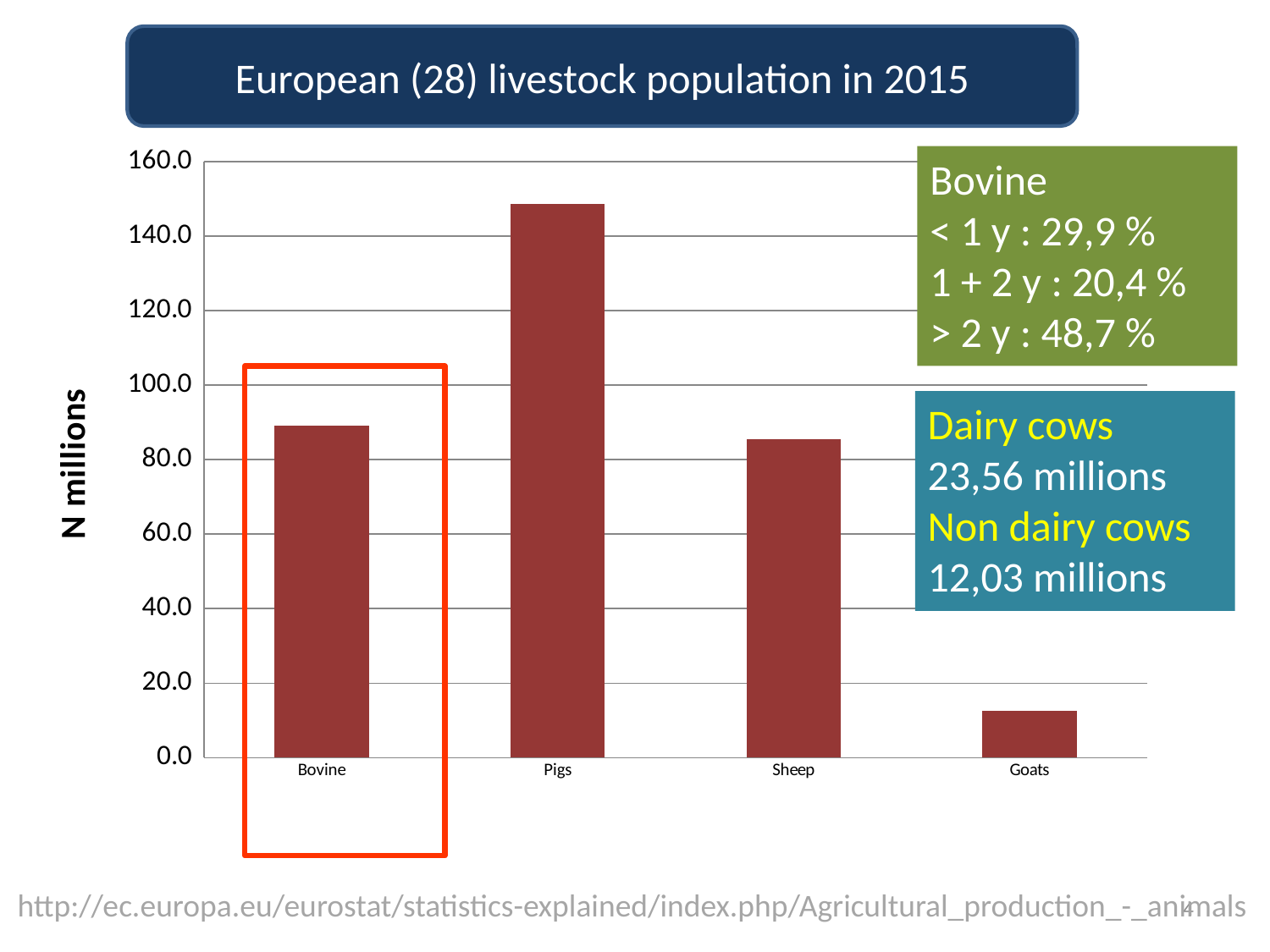
Which is larger, the value for Bovine or the value for Goats? Bovine How many categories are plotted on the x axis of the chart? 4 Which category has the lowest value in the chart? Goats Is the value for Bovine greater or less than 100? less Which category has the highest value in the chart? Pigs What is the label of the y axis of the chart? N millions Is the value for Pigs greater or less than 140? greater Is the value for Goats greater or less than 20? less What kind of chart is shown on the slide? bar chart Which is larger, the value for Pigs or the value for Sheep? Pigs What is the title of the chart on the slide? European (28) livestock population in 2015